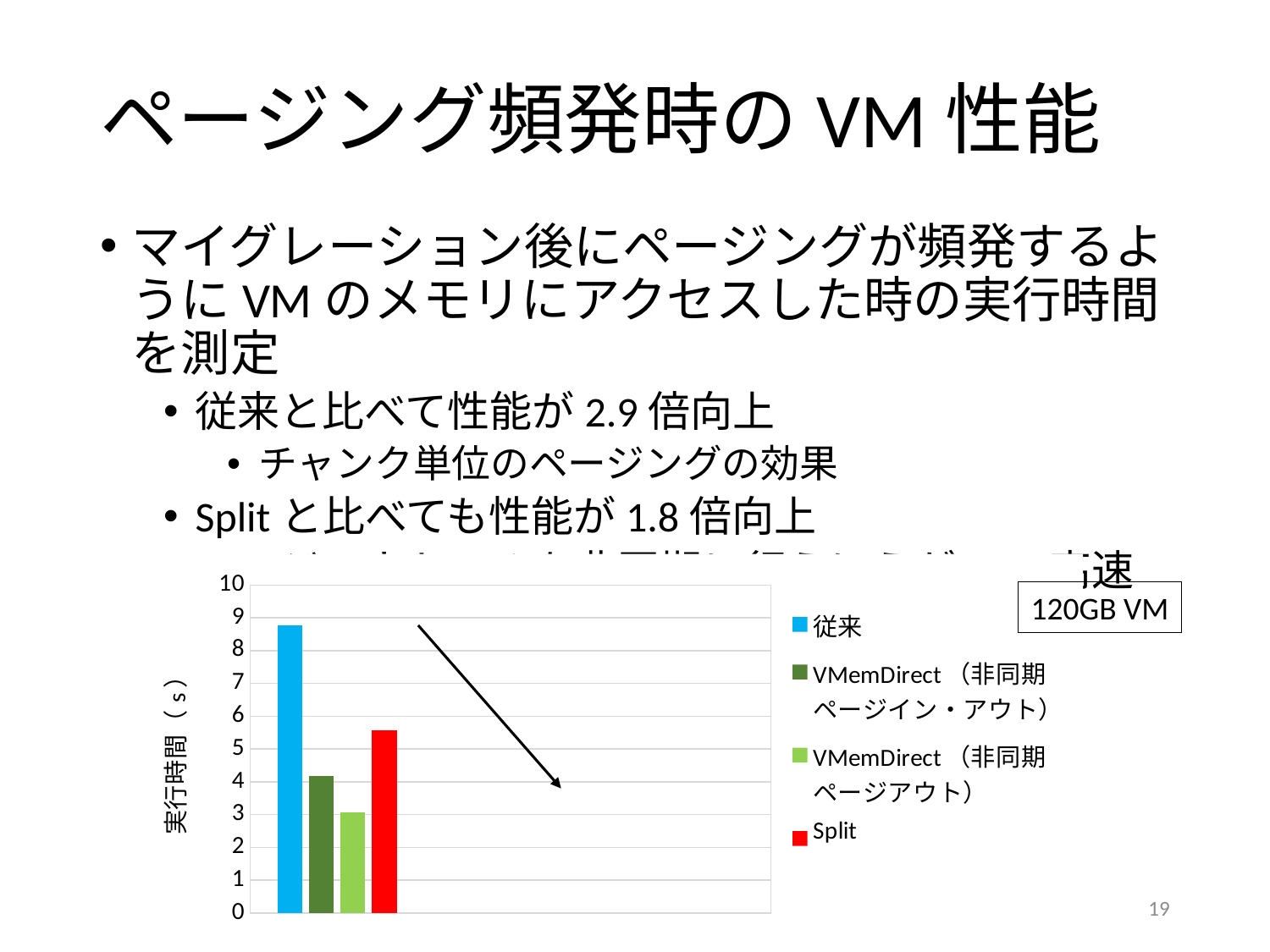
Is the execution time for VMemDirect（非同期ページアウト）greater or less than 4 s? less Which has a larger execution time, Split or VMemDirect（非同期ページイン・アウト）? Split Is the execution time for 従来 greater or less than 8 s? greater Which has a larger execution time, 従来 or Split? 従来 Is the execution time for Split greater or less than 5 s? greater How many series does the chart legend list? 4 Which series has the highest execution time in the chart? 従来 What is the label of the vertical axis of the chart? 実行時間（s） What colour is the bar for Split in the chart? red Which series has the lowest execution time in the chart? VMemDirect（非同期ページアウト） What kind of chart is shown on the slide? bar chart